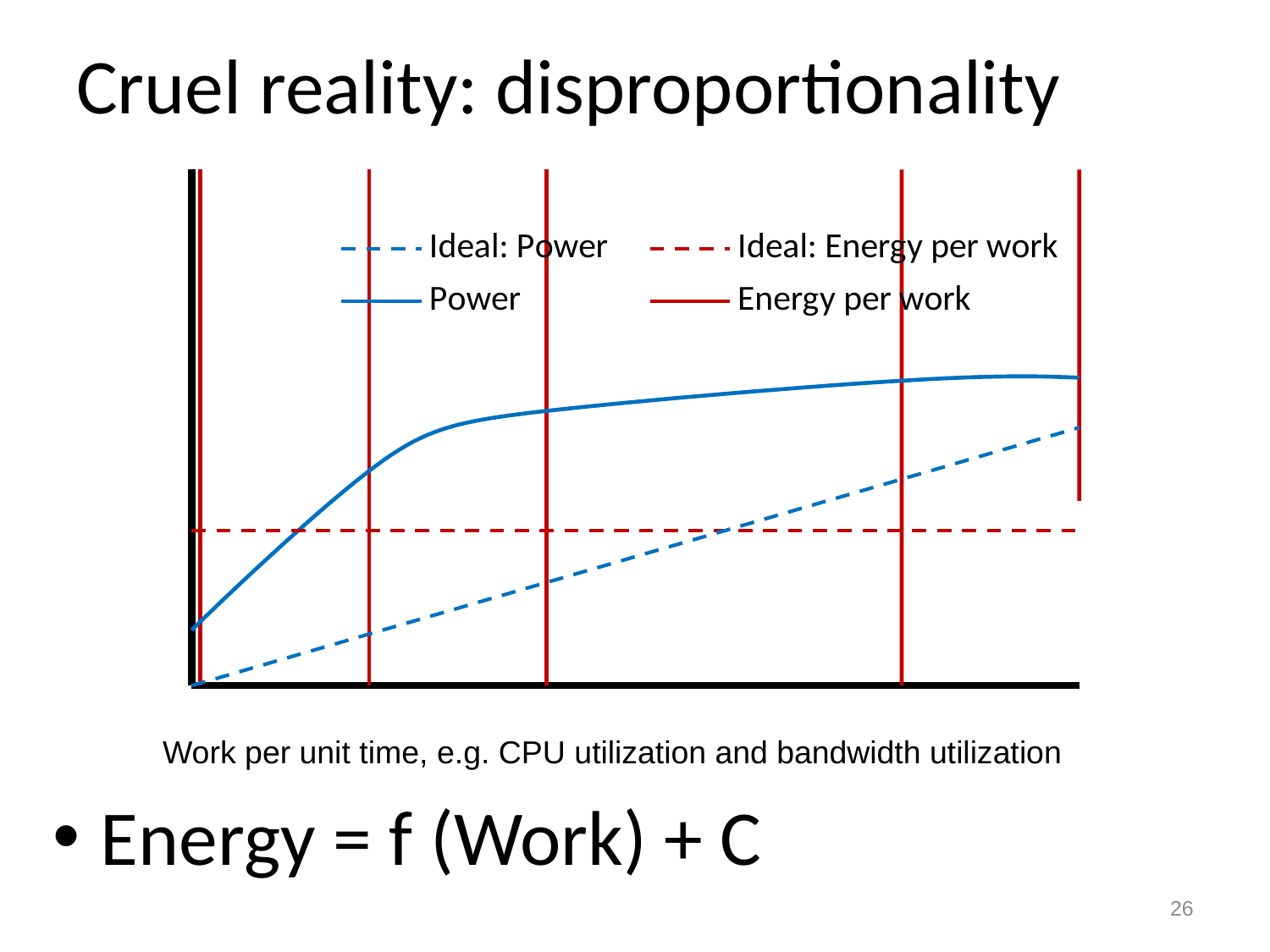
Does the solid Power line rise or fall as work per unit time increases along the x axis? rise Does the dashed Ideal: Power line rise or fall along the x axis? rise How many series does the chart's legend list? 4 What colour is the Power series drawn in? blue Which legend entry is drawn as a red dashed line? Ideal: Energy per work What kind of chart is shown on the slide? line chart Does the dashed Ideal: Energy per work line rise, fall, or stay flat along the x axis? stay flat